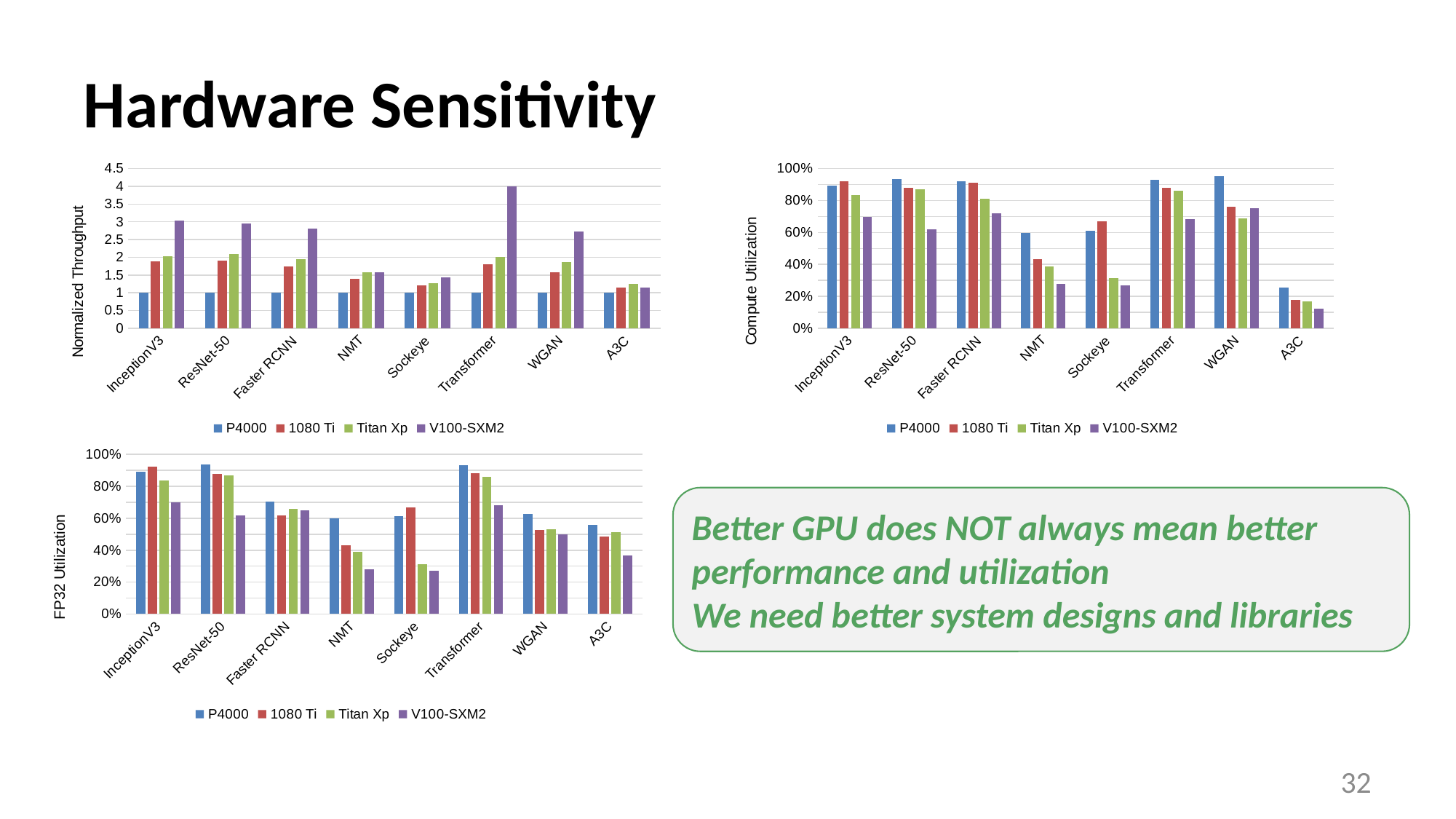
In the top-left Normalized Throughput chart, is the V100-SXM2 value for Transformer greater or less than 3.5? greater How many categories are shown on the x axis of the bottom-left FP32 Utilization chart? 8 In the bottom-left FP32 Utilization chart, which is larger for Sockeye: 1080 Ti or Titan Xp? 1080 Ti In the top-right Compute Utilization chart, which category has the lowest V100-SXM2 value? A3C In the bottom-left FP32 Utilization chart, is the V100-SXM2 value for NMT greater or less than 40%? less In the top-left Normalized Throughput chart, what is the value for P4000 for InceptionV3? 1 In the top-left Normalized Throughput chart, which category has the highest V100-SXM2 value? Transformer In the top-right Compute Utilization chart, is the V100-SXM2 value for A3C greater or less than 20%? less In the top-right Compute Utilization chart, which is larger for NMT: P4000 or V100-SXM2? P4000 Which series is shown in purple in the legend of the bottom-left FP32 Utilization chart? V100-SXM2 How many series does the legend of the top-right Compute Utilization chart list? 4 What kind of chart is the top-left chart with the Normalized Throughput axis? bar chart